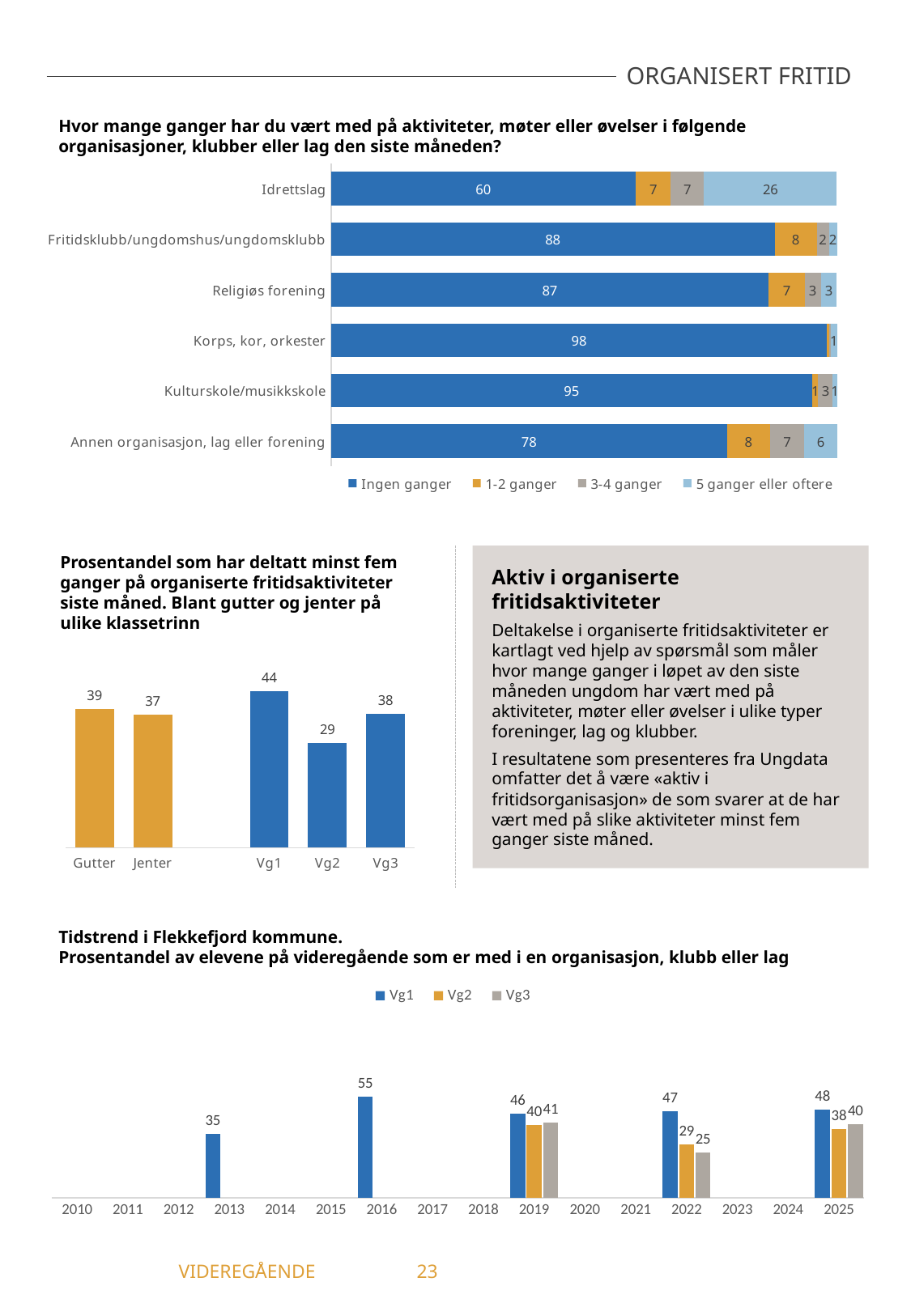
What type of chart is the bottom chart (Tidstrend i Flekkefjord kommune)? Bar chart In the middle-left chart, which is larger, Gutter or Jenter? Gutter In the top chart, what is the difference between the 'Ingen ganger' values for Fritidsklubb/ungdomshus/ungdomsklubb and Idrettslag? 28 In the middle-left chart, which category has the highest value? Vg1 In the top chart, how many series does the legend list? 4 In the bottom chart, what is the difference between the Vg1 and Vg3 values in 2022? 22 In the top chart, which category has the highest 'Ingen ganger' value? Korps, kor, orkester In the top chart, what is the value for '5 ganger eller oftere' for Idrettslag? 26 In the top chart (Hvor mange ganger har du vært med på aktiviteter...), what percentage answered 'Ingen ganger' for Idrettslag? 60 In the middle-left chart (Prosentandel som har deltatt minst fem ganger...), what is the value for Vg2? 29 In the bottom chart (Tidstrend i Flekkefjord kommune), what is the Vg1 value for 2016? 55 In the top chart, how many categories (organisation types) are shown? 6